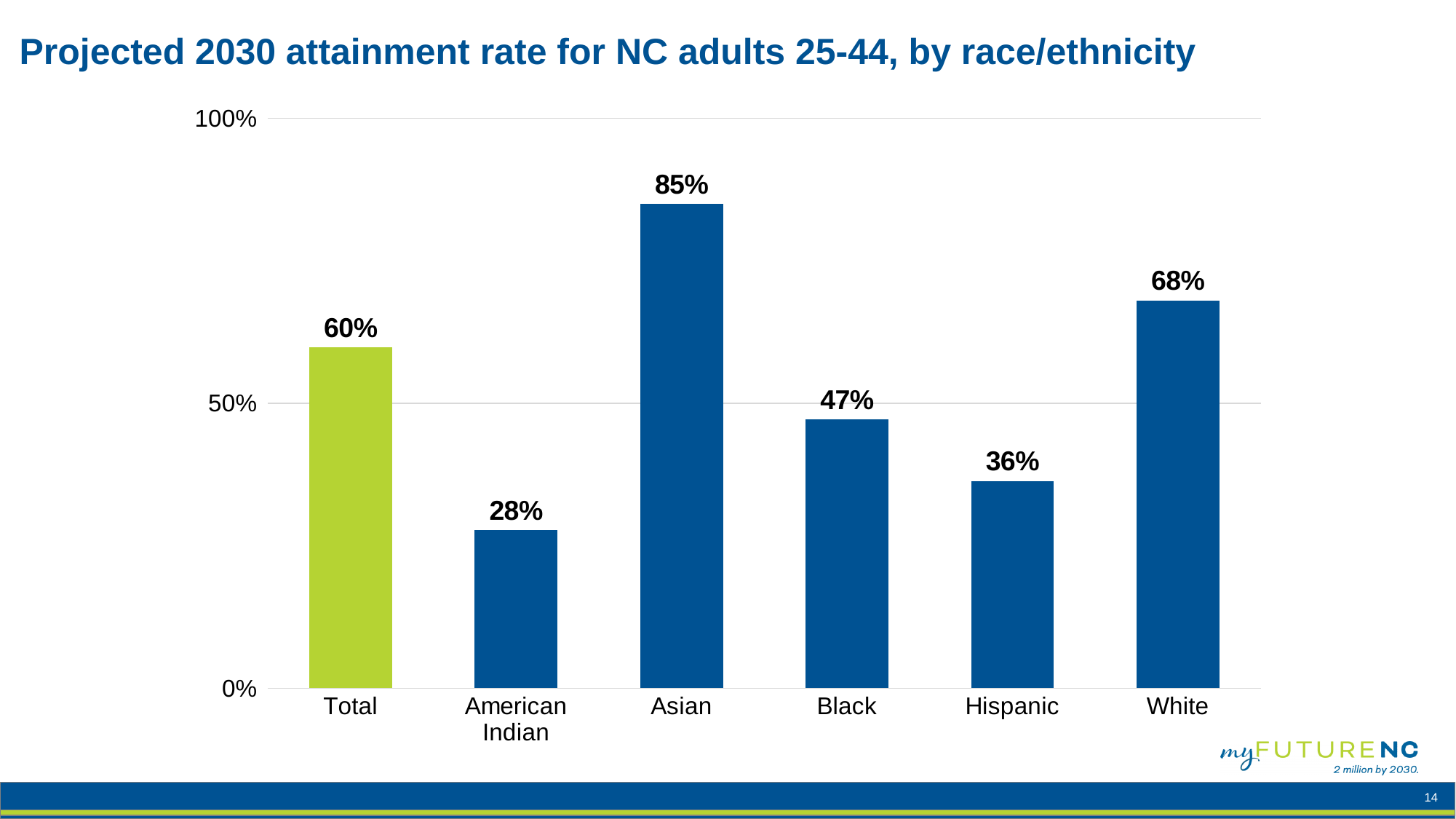
What is the difference between the projected attainment rates for White and Black adults? 21% What is the projected 2030 attainment rate for Hispanic adults? 36% Which race/ethnicity category has the lowest projected attainment rate? American Indian What kind of chart is shown on the slide? Bar chart Which has a higher projected attainment rate, Black or Hispanic? Black What is the projected 2030 attainment rate for Asian adults? 85% Is the projected attainment rate for White adults greater or less than 50%? greater How many categories are shown on the x axis? 6 Which race/ethnicity category has the highest projected attainment rate? Asian What is the difference between the projected attainment rates for Asian and American Indian adults? 57% What is the projected 2030 attainment rate for the Total category? 60% Which bar is shown in a different colour (green) from the others? Total